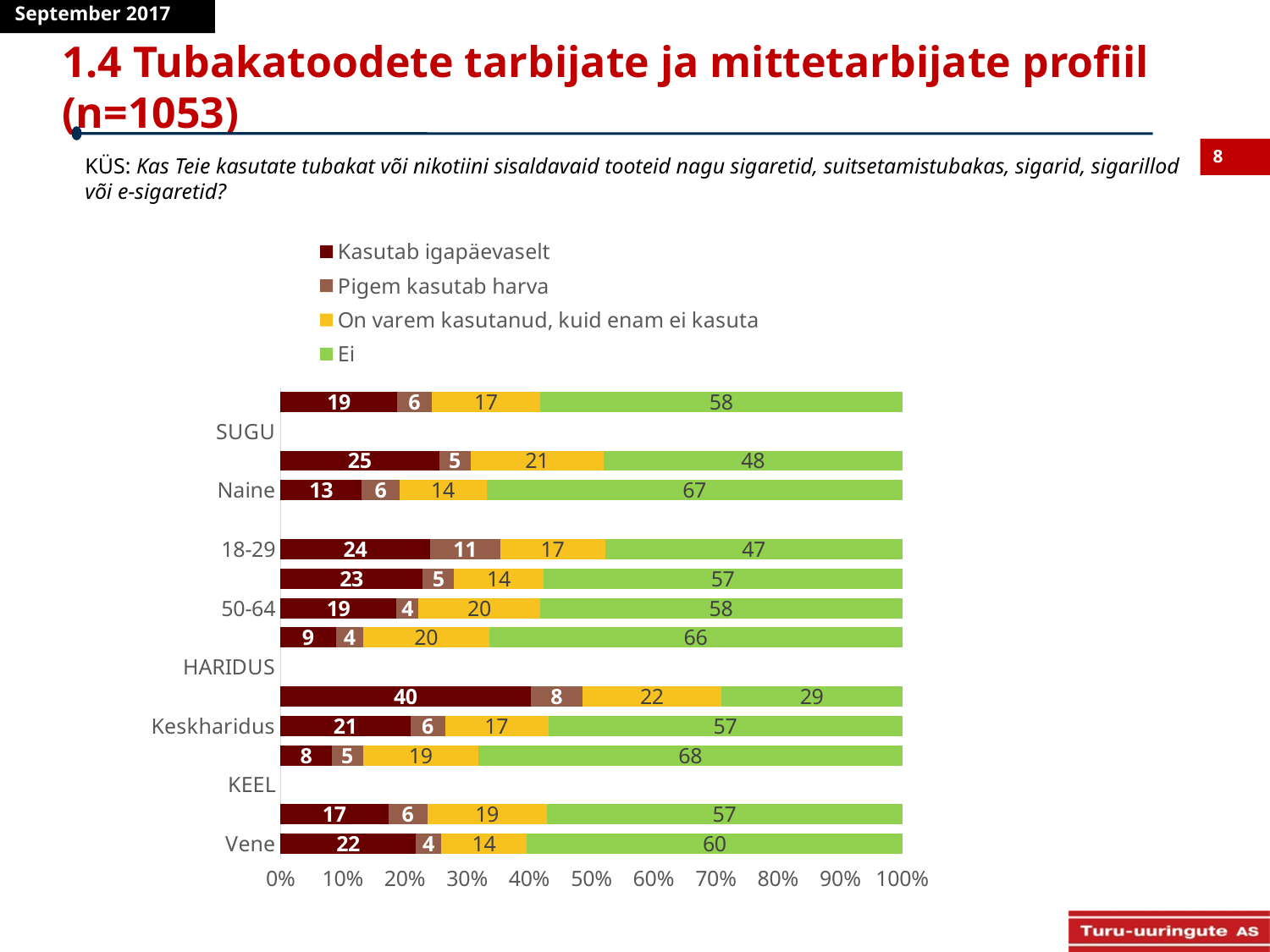
What is the value of "Ei" for the Keskharidus category? 57 What is the difference between the "Ei" values for Naine and 18-29? 20 What is the value of "Kasutab igapäevaselt" for the Vene category? 22 What is the value of "Ei" for the Naine category? 67 Which has the larger "Kasutab igapäevaselt" value, Naine or Vene? Vene What kind of chart is shown on the slide? Stacked bar chart What is the value of "On varem kasutanud, kuid enam ei kasuta" for the 50-64 category? 20 What is the value of "Pigem kasutab harva" for the 18-29 category? 11 What is the first entry in the chart legend? Kasutab igapäevaselt Among Naine, 18-29, 50-64, Keskharidus and Vene, which category has the highest "Ei" value? Naine How many series does the legend list? 4 What is the total of the stacked bar for the Naine category? 100